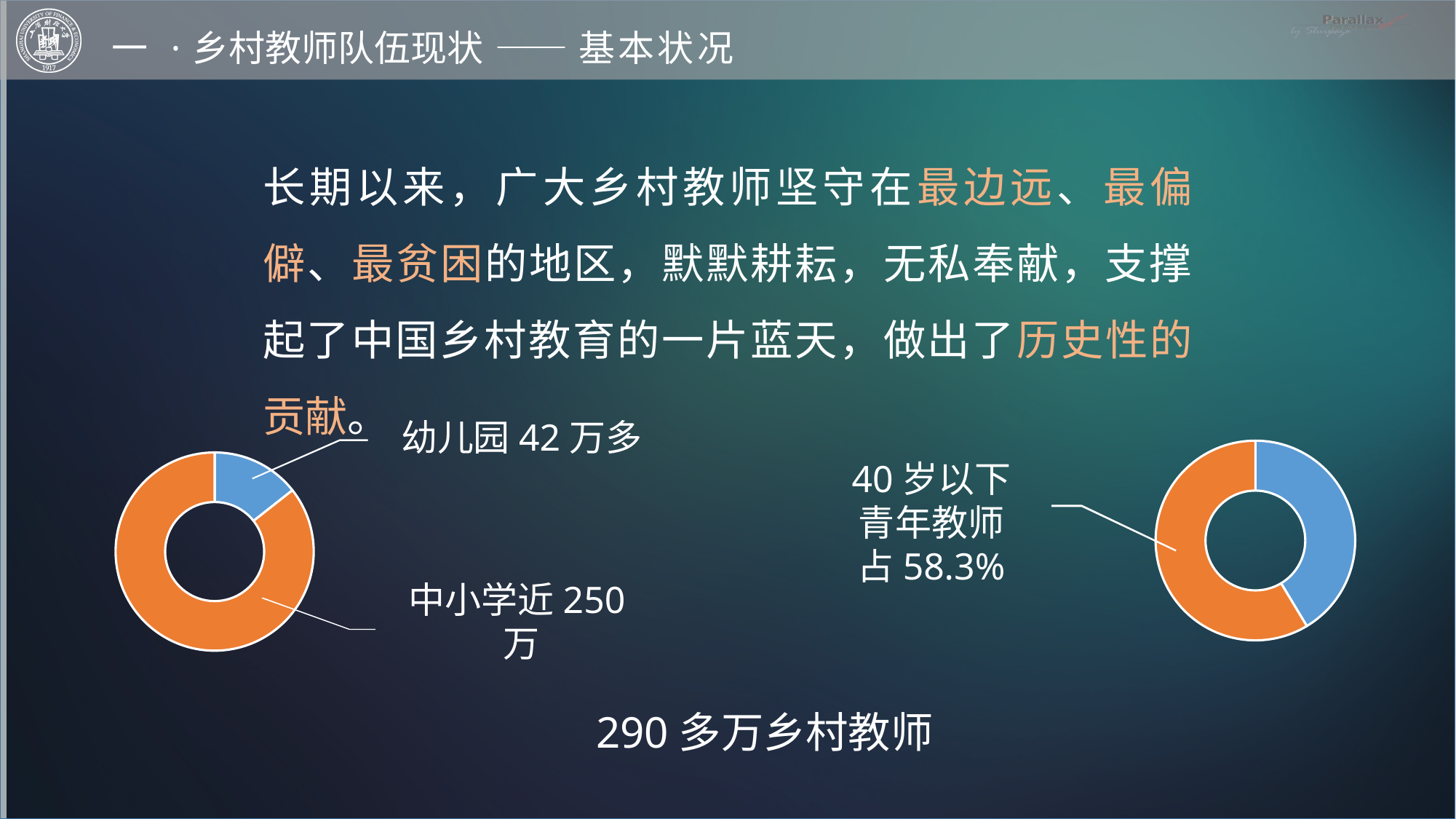
In the left chart, what value is printed for 中小学? 近 250 万 In the right chart, what share is printed for 40 岁以下青年教师? 58.3% How many slices does the left chart have? 2 In the right chart, which slice is larger, the orange one or the blue one? the orange one In the right chart, is the share of the orange slice greater or less than 50%? greater In the left chart, what colour is the 幼儿园 slice? Blue In the left chart, what label is attached to the blue slice? 幼儿园 42 万多 In the left chart, which slice is larger, 幼儿园 or 中小学? 中小学 How many slices does the right chart have? 2 What total number of rural teachers is stated in the text below the two charts? 290 多万乡村教师 What kind of chart is the chart on the left of the slide? Doughnut (pie) chart